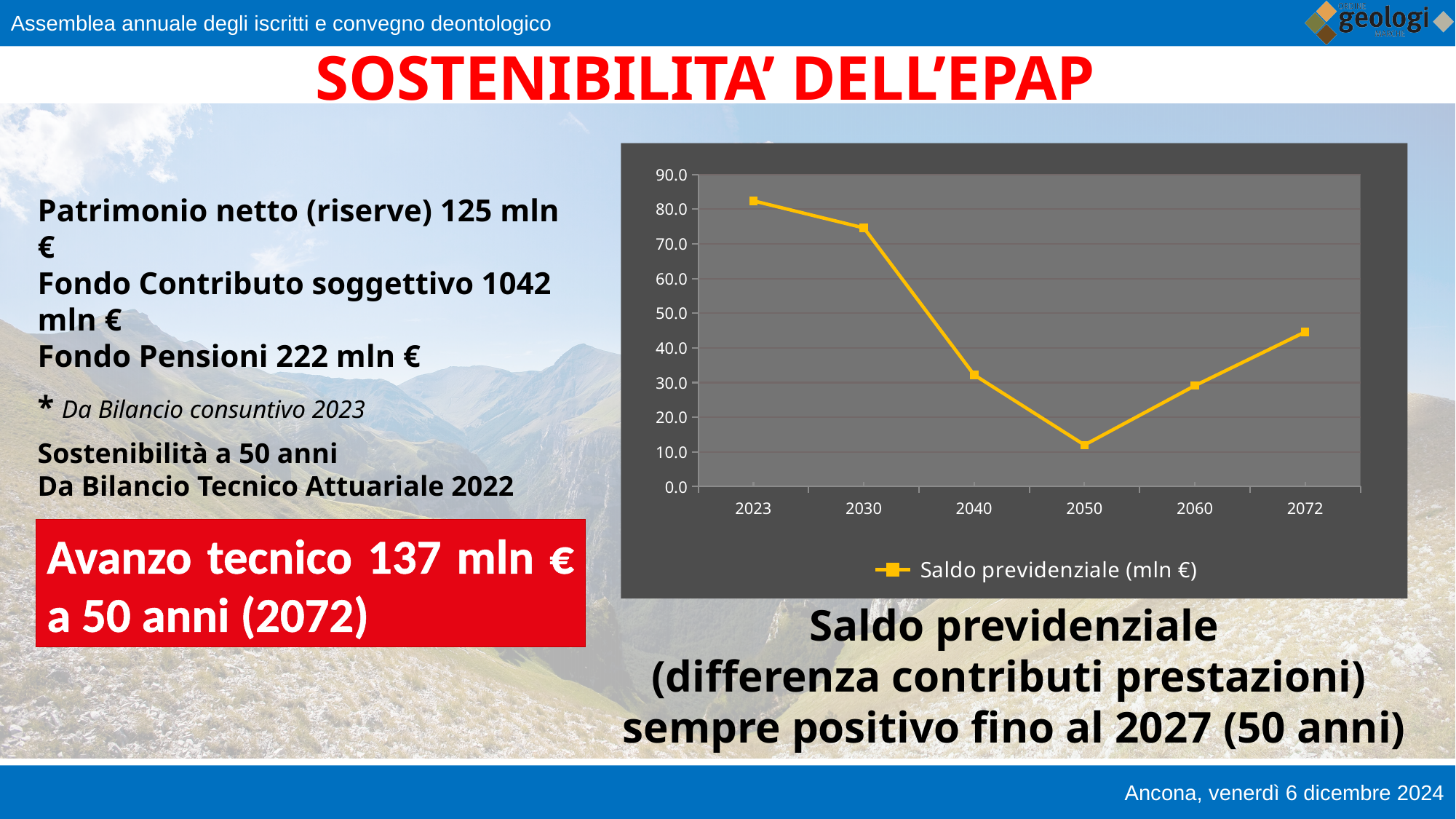
In which year is the Saldo previdenziale lowest? 2050 Is the value for 2023 greater or less than 80.0? greater Is the value for 2040 greater or less than 40.0? less Which year has a larger Saldo previdenziale, 2030 or 2060? 2030 Does the Saldo previdenziale rise or fall from 2023 to 2050? fall How many series does the chart legend list? 1 What kind of chart is shown on the slide? line chart How many years are plotted on the x axis of the chart? 6 What is the name of the series shown in the chart legend? Saldo previdenziale (mln €) Is the value for 2072 greater or less than 40.0? greater In which year is the Saldo previdenziale highest? 2023